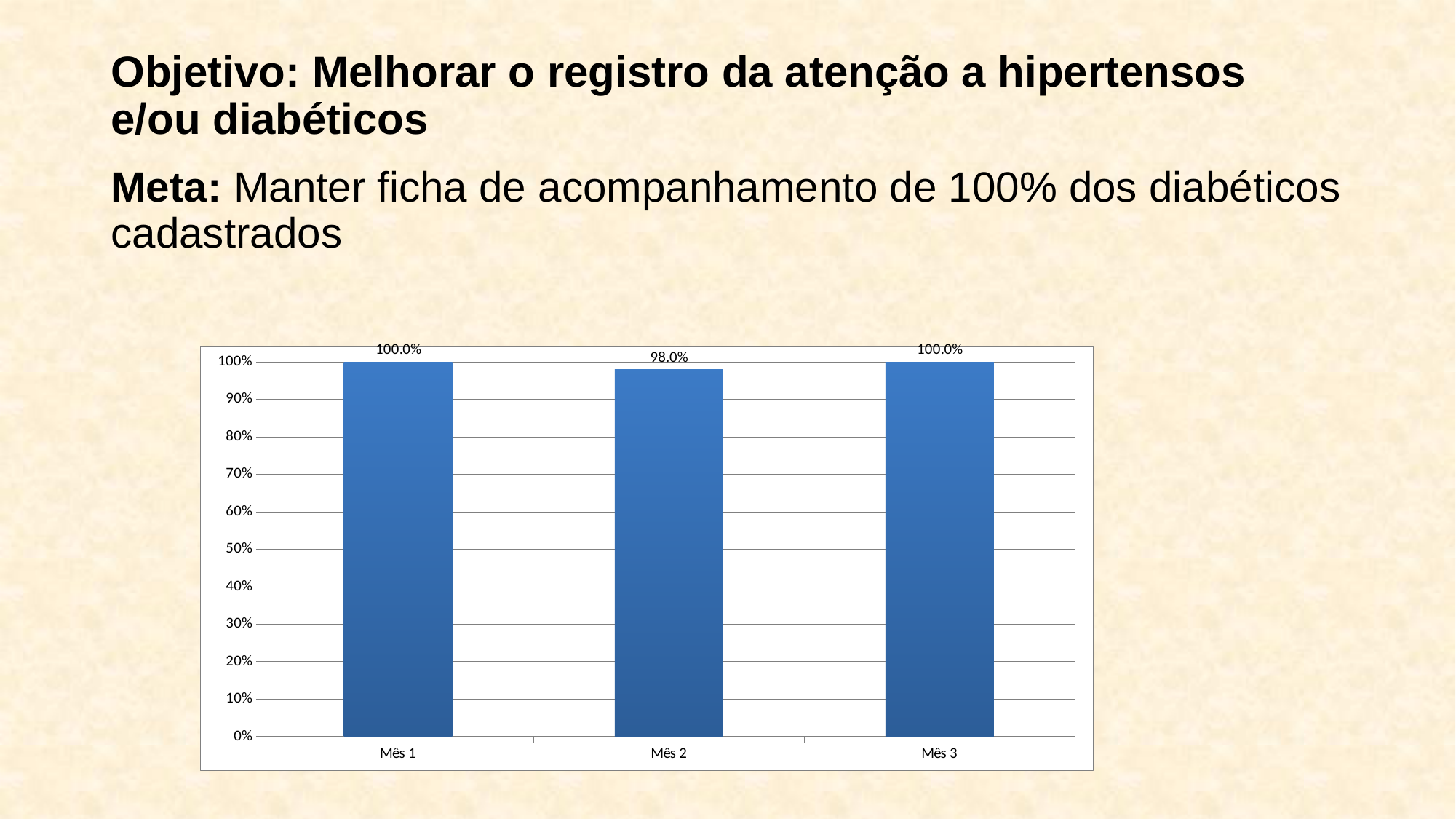
Which is larger, the value for Mês 2 or the value for Mês 3? Mês 3 What is the value for Mês 2? 98.0% Is the value for Mês 2 greater or less than 90%? greater What is the value for Mês 1? 100.0% What is the difference between the values for Mês 1 and Mês 2? 2.0% Does the value rise or fall from Mês 2 to Mês 3? rise What kind of chart is shown on the slide? bar chart What is the value for Mês 3? 100.0% How many categories are shown on the x axis? 3 What is the highest tick label on the y axis? 100% What colour are the bars in the chart? blue Which month has the lowest value? Mês 2